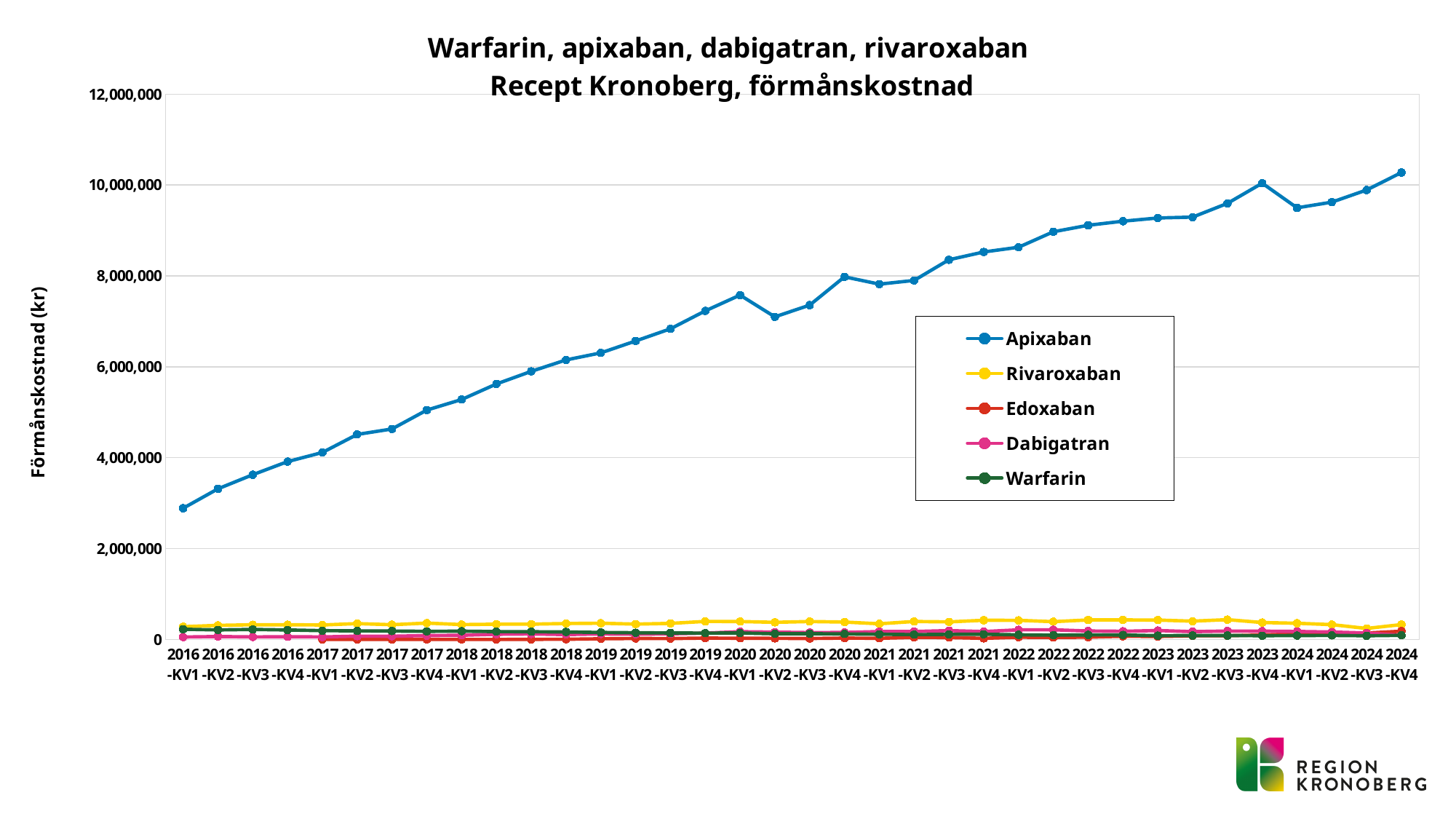
Is the value for Apixaban in 2016-KV1 greater or less than 4,000,000? less What kind of chart is shown on the slide? Line chart Which series has the highest förmånskostnad in 2024-KV4? Apixaban Which is larger in 2019-KV1: the value for Apixaban or the value for Warfarin? Apixaban How many quarterly data points are plotted along the x axis for each series? 36 Which series is drawn in yellow? Rivaroxaban Is the value for Apixaban in 2020-KV1 greater or less than 8,000,000? less What is the label on the y axis? Förmånskostnad (kr) Is the value for Rivaroxaban in 2022-KV1 greater or less than 2,000,000? less Does the Apixaban series generally rise or fall from 2016-KV1 to 2024-KV4? Rise How many series does the legend list? 5